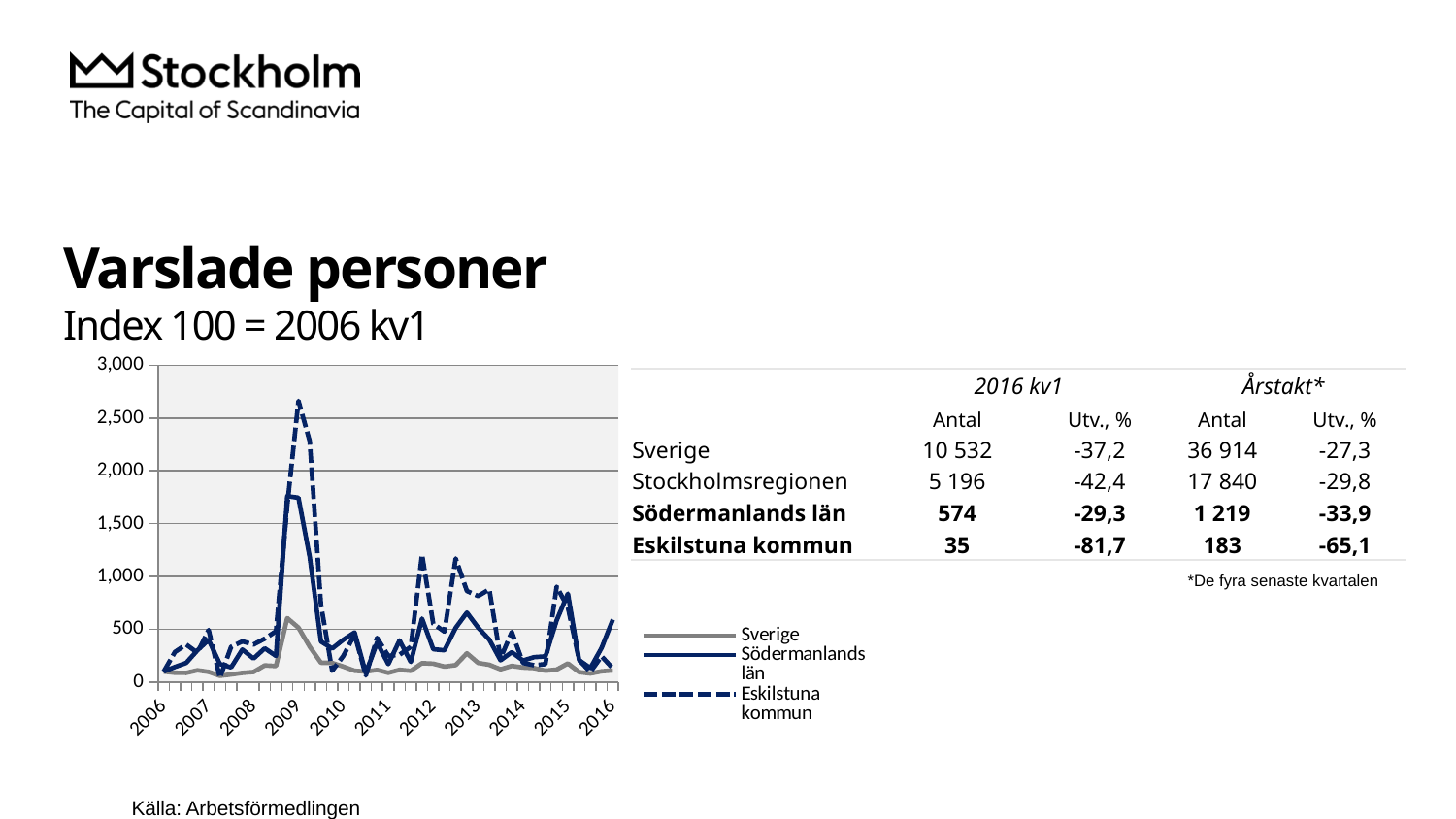
Which series reaches the highest peak in the chart? Eskilstuna kommun What is the title of the chart on the slide? Varslade personer Around 2009, which series is higher: Södermanlands län or Sverige? Södermanlands län How many series does the chart legend list? 3 Is the peak value for Eskilstuna kommun around 2009 greater or less than 2,000? greater Which series are listed in the chart legend? Sverige, Södermanlands län, Eskilstuna kommun How many year labels are shown along the x axis of the chart? 11 Which series stays lowest across the chart? Sverige What kind of chart is shown on the slide? line chart Is the peak value for Sverige around 2009 greater or less than 1,000? less What is the highest value shown on the y axis of the chart? 3,000 Is the peak value for Södermanlands län around 2009 greater or less than 1,500? greater